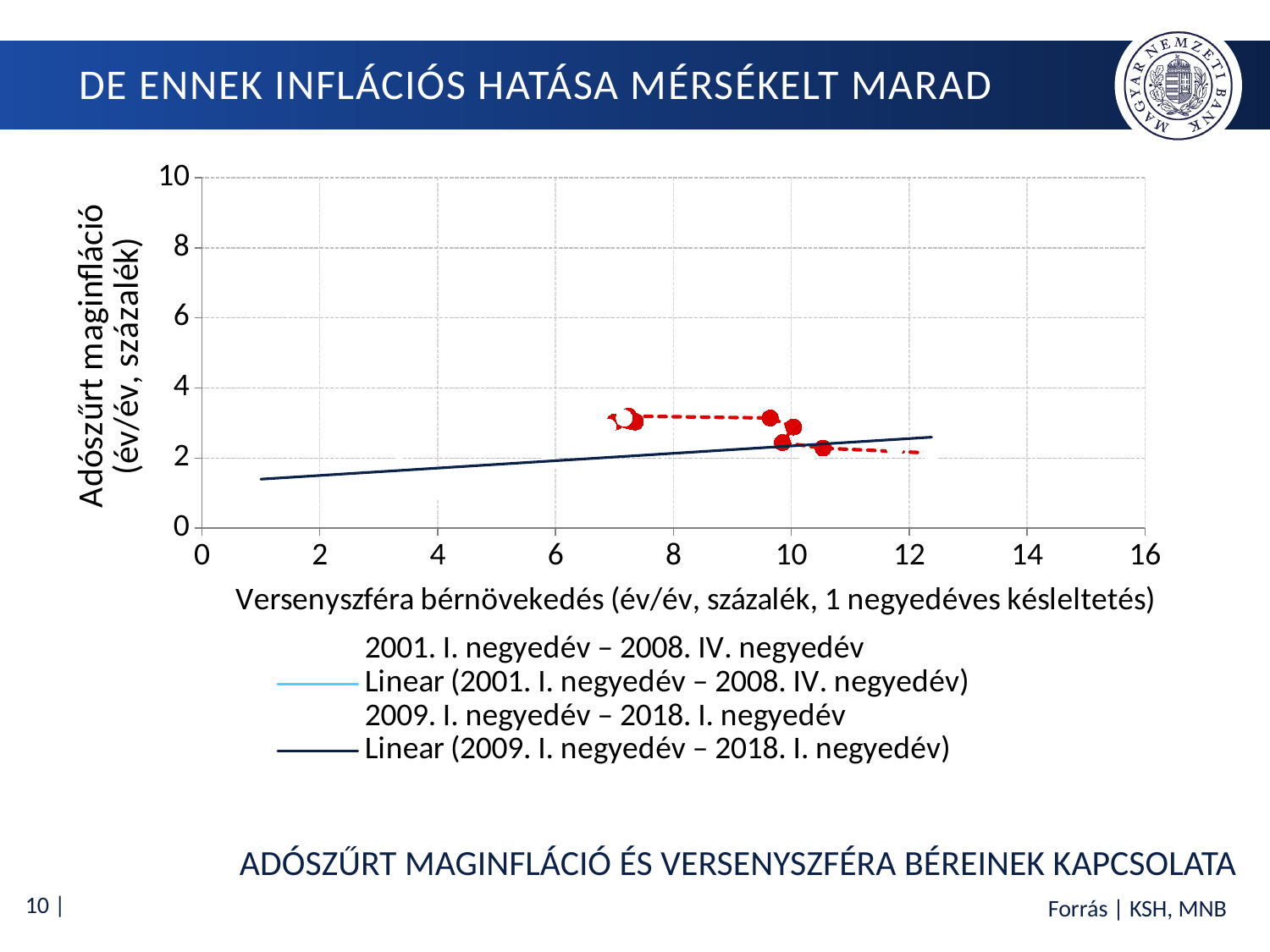
Are the plotted red data points greater or less than 4 on the vertical axis? less What kind of chart is shown on the slide? scatter chart Are the plotted red data points greater or less than 6 on the horizontal axis? greater What is the title of the chart? ADÓSZŰRT MAGINFLÁCIÓ ÉS VERSENYSZFÉRA BÉREINEK KAPCSOLATA What is the maximum value shown on the vertical axis? 10 How many entries does the chart legend list? 4 Does the dark 'Linear (2009. I. negyedév – 2018. I. negyedév)' trend line rise or fall as the x-axis value increases? rise What is the maximum value shown on the horizontal axis? 16